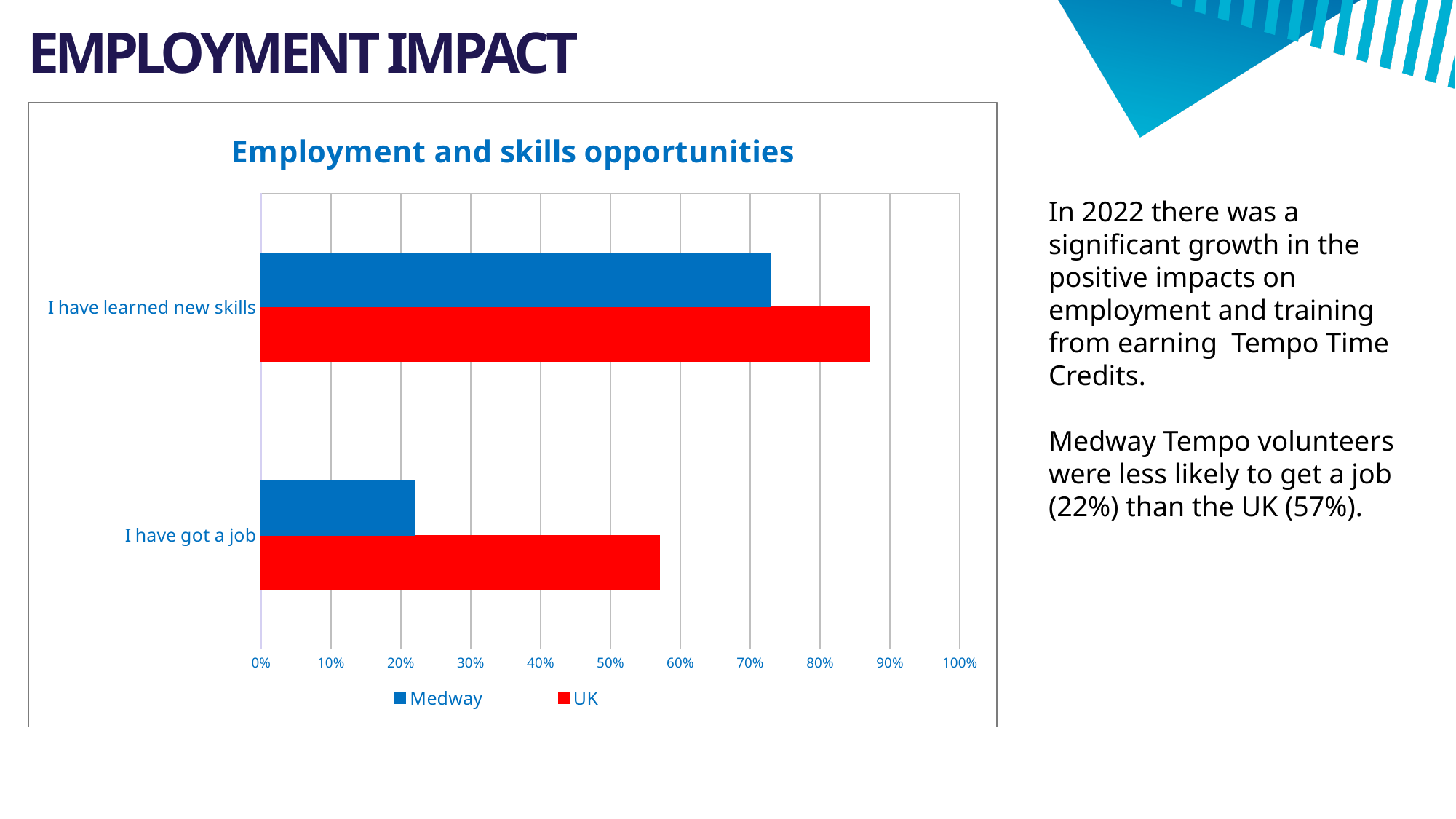
What is the title of the chart? Employment and skills opportunities Is the Medway value for 'I have learned new skills' greater or less than 70%? greater What is the difference between the UK and Medway values for 'I have got a job'? 35% Which is larger for 'I have learned new skills', the Medway value or the UK value? UK What is the Medway value for 'I have got a job'? 22% How many series does the chart legend list? 2 Which category has the highest UK value? I have learned new skills Is the UK value for 'I have learned new skills' greater or less than 80%? greater What is the UK value for 'I have got a job'? 57% What type of chart is shown on the slide? bar chart How many categories are shown on the chart? 2 Which colour represents the UK series in the chart? red